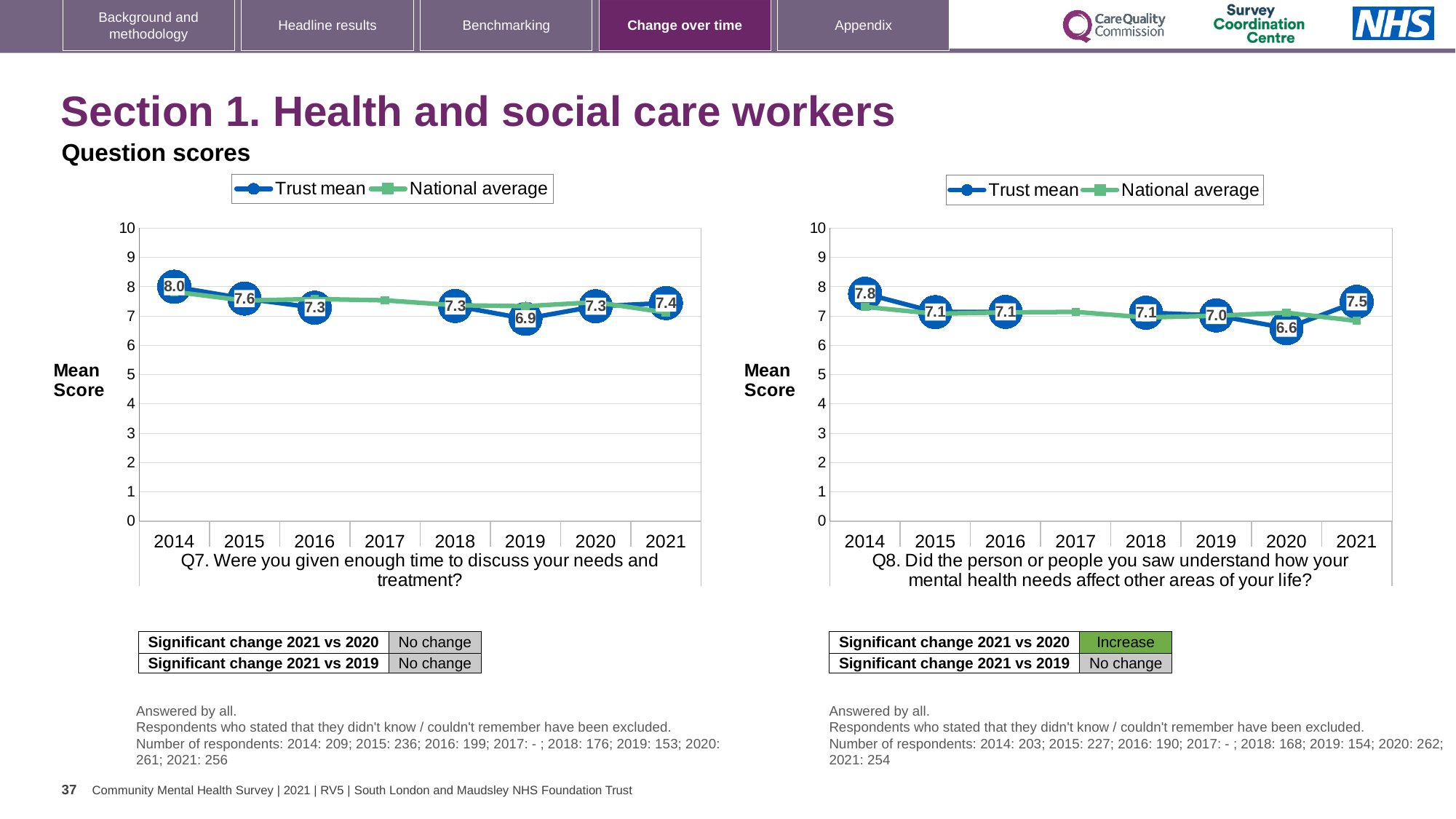
How many years are shown on the x axis of the Q7 chart on the left? 8 In the Q8 chart on the right, what does the table say about the significant change 2021 vs 2020? Increase In the Q8 chart on the right, which year has the highest Trust mean score? 2014 How many series does the legend of the Q8 chart on the right list? 2 In the Q8 chart on the right, is the Trust mean score higher in 2019 or in 2021? 2021 In the Q7 chart on the left, which year has the lowest Trust mean score? 2019 In the Q7 chart on the left, what is the Trust mean score for 2014? 8.0 In the Q7 chart on the left, is the National average value for 2014 greater or less than 7? greater What type of chart is the Q7 chart on the left? Line chart In the Q8 chart on the right, what is the Trust mean score for 2020? 6.6 In the Q8 chart on the right, what is the difference between the Trust mean scores for 2021 and 2020? 0.9 In the Q7 chart on the left, what is the difference between the Trust mean scores for 2014 and 2021? 0.6